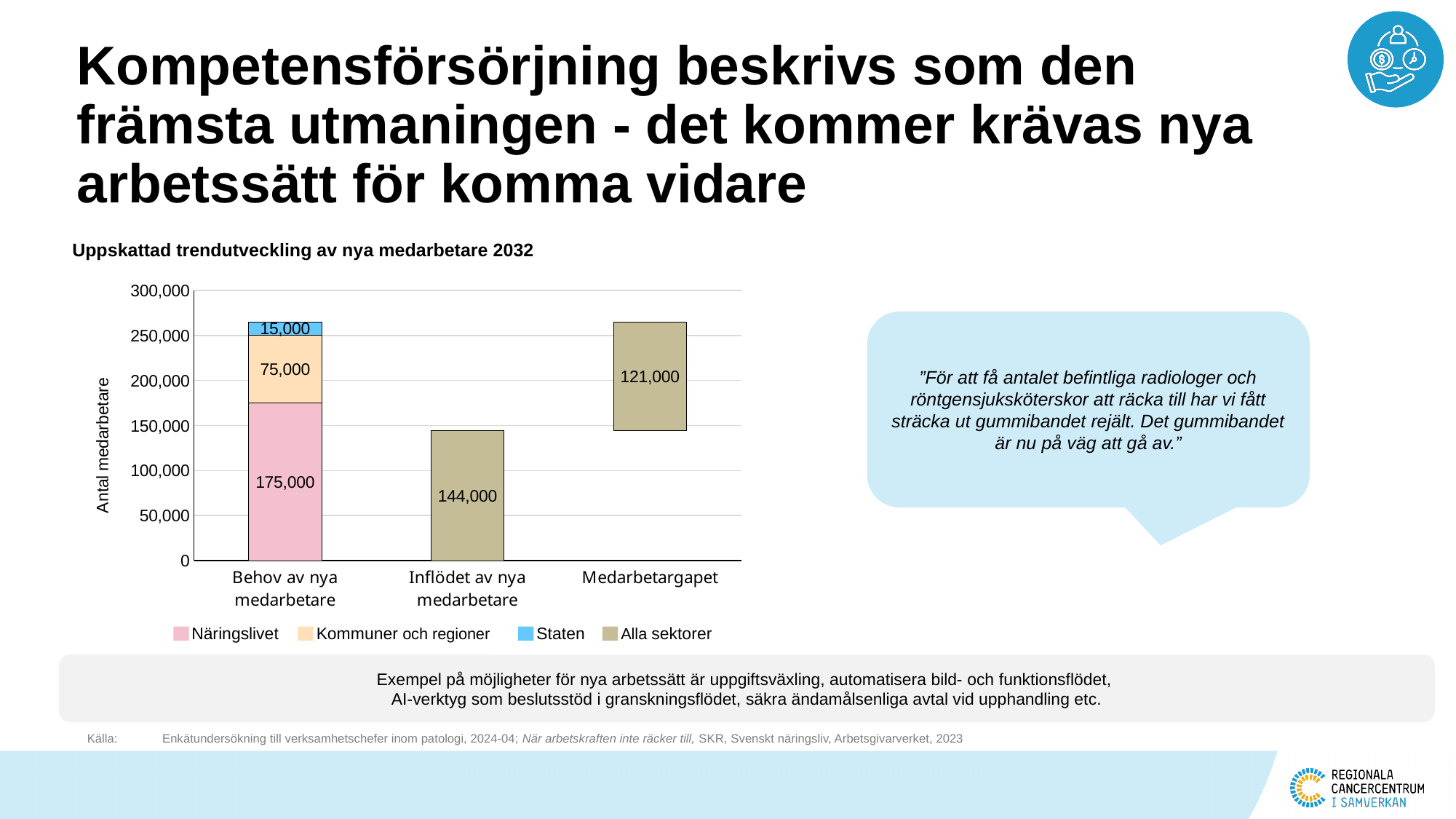
How many categories are shown on the x axis of the chart? 3 What is the value for Näringslivet in the 'Behov av nya medarbetare' bar? 175,000 What is the difference between the Näringslivet value (175,000) and the Kommuner och regioner value (75,000) in the 'Behov av nya medarbetare' bar? 100,000 What type of chart is shown on the slide? Stacked bar chart What is the title of the chart? Uppskattad trendutveckling av nya medarbetare 2032 What is the value for Kommuner och regioner in the 'Behov av nya medarbetare' bar? 75,000 What is the total of the stacked 'Behov av nya medarbetare' bar? 265,000 How many series does the chart legend list? 4 What is the value shown for 'Inflödet av nya medarbetare'? 144,000 Which is larger, the value for 'Inflödet av nya medarbetare' or the value for 'Medarbetargapet'? Inflödet av nya medarbetare What is the value for Staten in the 'Behov av nya medarbetare' bar? 15,000 What is the value shown for 'Medarbetargapet'? 121,000